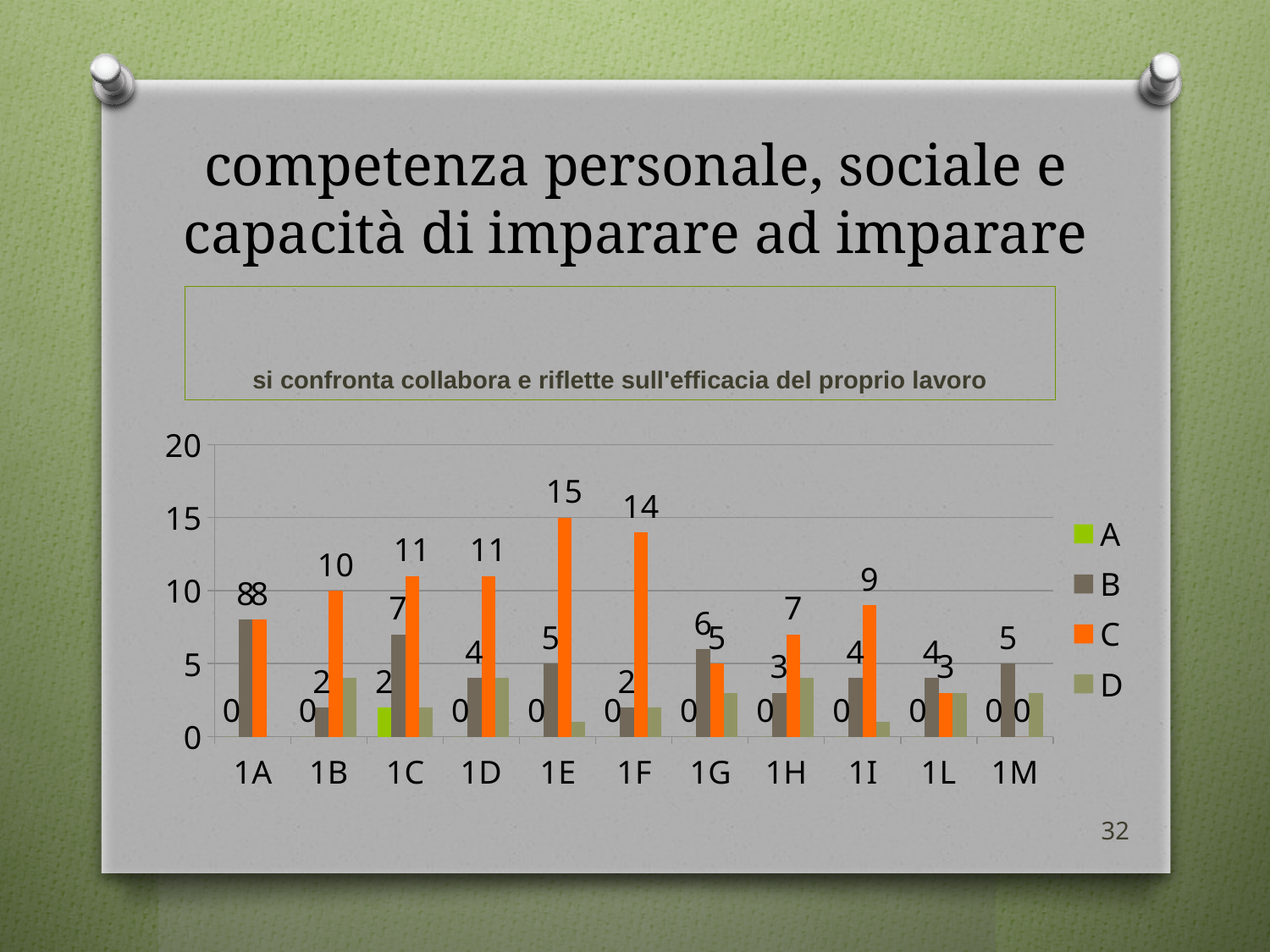
What is the difference between the series C values for 1E and 1F? 1 Is the value of series D for category 1E greater or less than 5? less How many categories are shown on the x axis? 11 What is the value of series C for category 1M? 0 Which category has the larger series B value, 1C or 1D? 1C What is the value of series B for category 1G? 6 What is the value of series A for category 1C? 2 What is the value of series C for category 1E? 15 Which category has the highest value for series C? 1E What kind of chart is shown on the slide? bar chart How many series does the legend list? 4